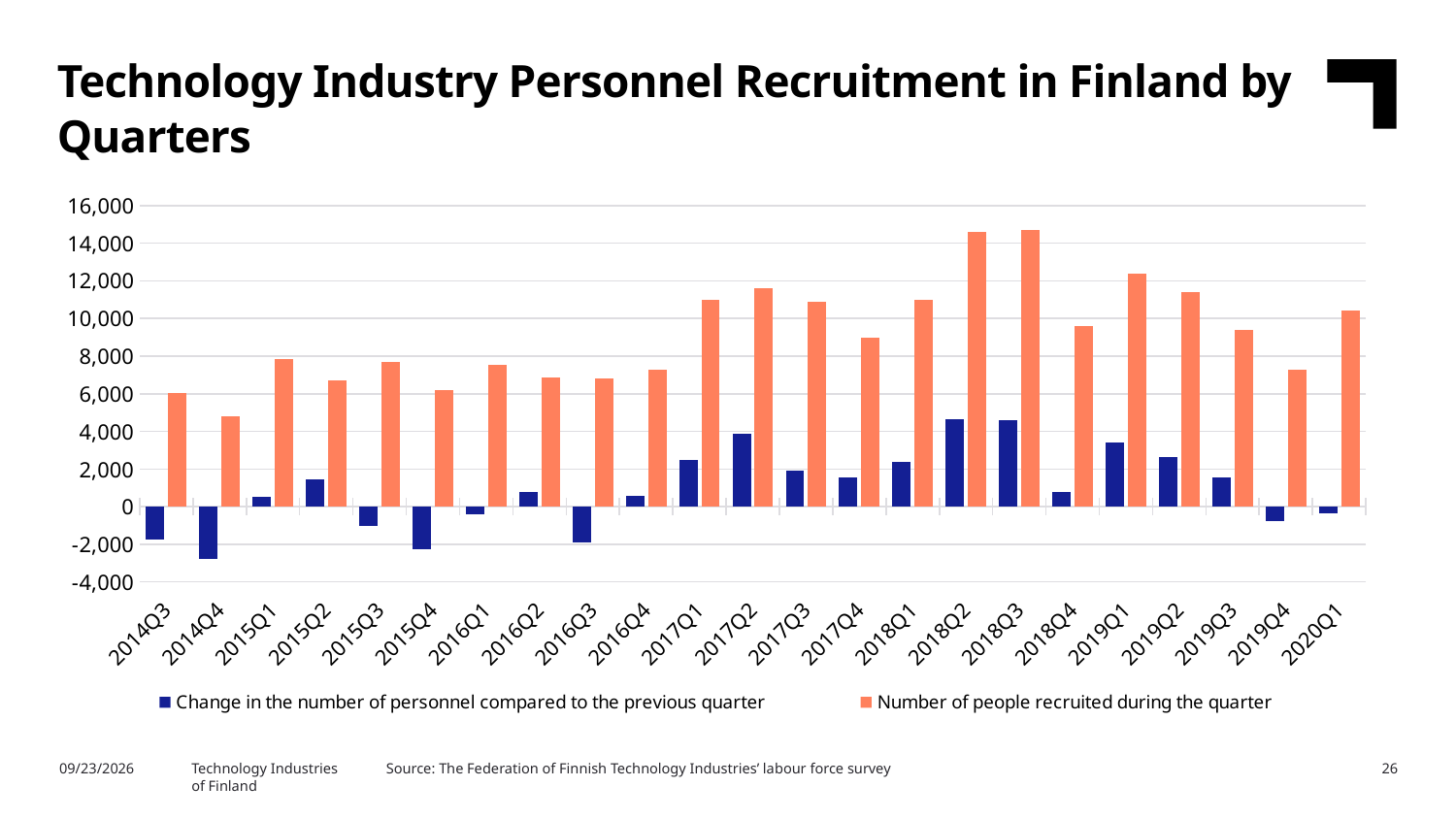
How many quarters are shown on the x axis? 23 Which quarter had more people recruited, 2018Q1 or 2018Q4? 2018Q1 Which quarter has the lowest (most negative) change in the number of personnel compared to the previous quarter? 2014Q4 Is the number of people recruited in 2019Q1 greater or less than 12,000? greater Is the change in the number of personnel in 2016Q3 greater or less than 0? less Is the number of people recruited in 2018Q2 greater or less than 14,000? greater Does the number of people recruited rise or fall from 2019Q1 to 2019Q4? fall Which quarter has the lowest number of people recruited during the quarter? 2014Q4 What kind of chart is shown on the slide? Bar chart How many series does the legend list? 2